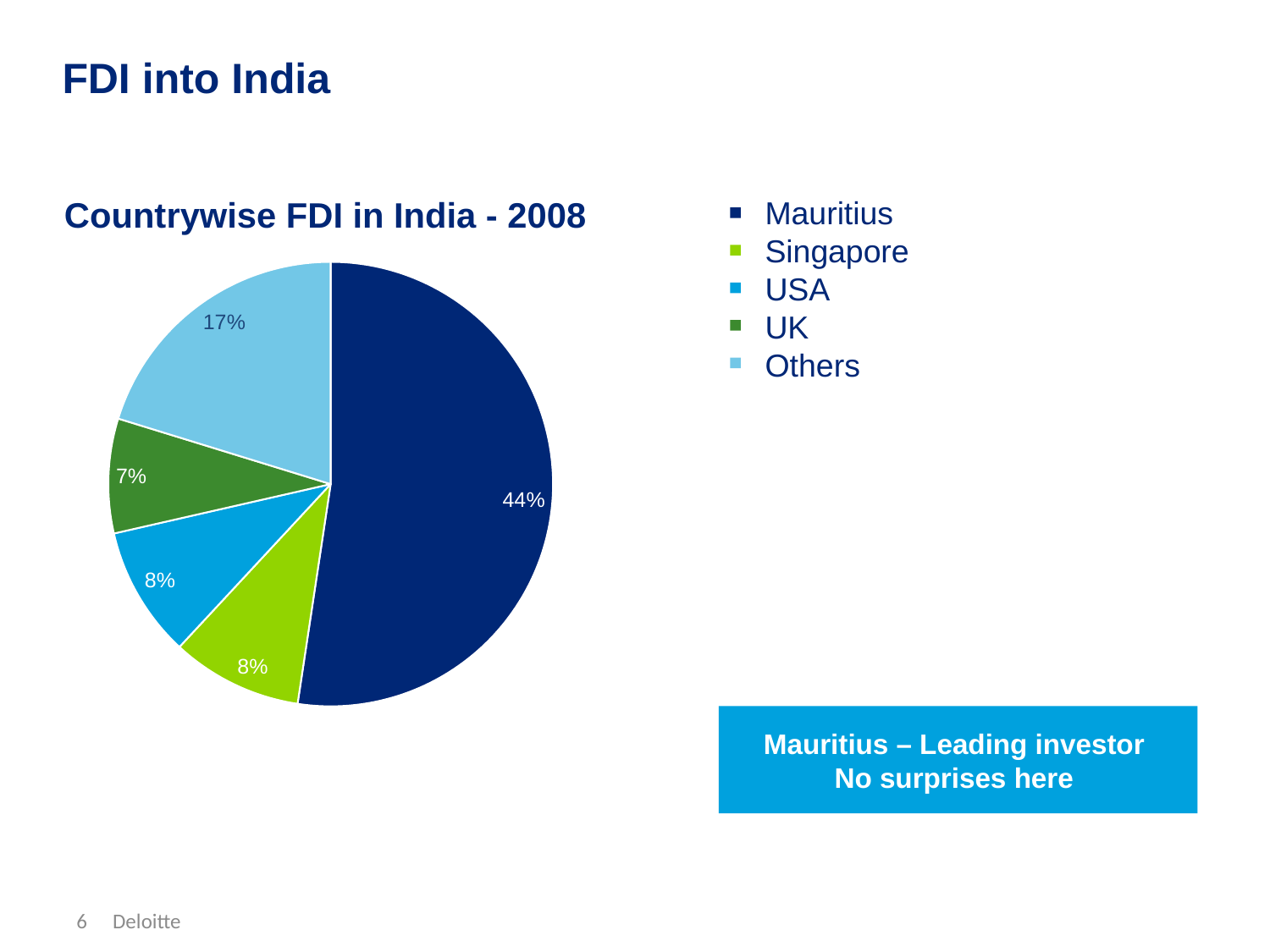
Which slice is larger, Others or Singapore? Others What is the title of the pie chart? Countrywise FDI in India - 2008 What is the difference in percentage points between the Mauritius slice and the Others slice? 27 What kind of chart is shown on the slide? pie chart What share of FDI into India in 2008 came from Mauritius? 44% What share of FDI into India in 2008 came from the UK? 7% What percentage of the pie is labelled for Others? 17% How many slices does the pie chart have? 5 Which country has the largest slice of the pie? Mauritius What share of FDI into India in 2008 came from the USA? 8% Which named country has the smallest slice of the pie? UK How many entries does the legend list? 5